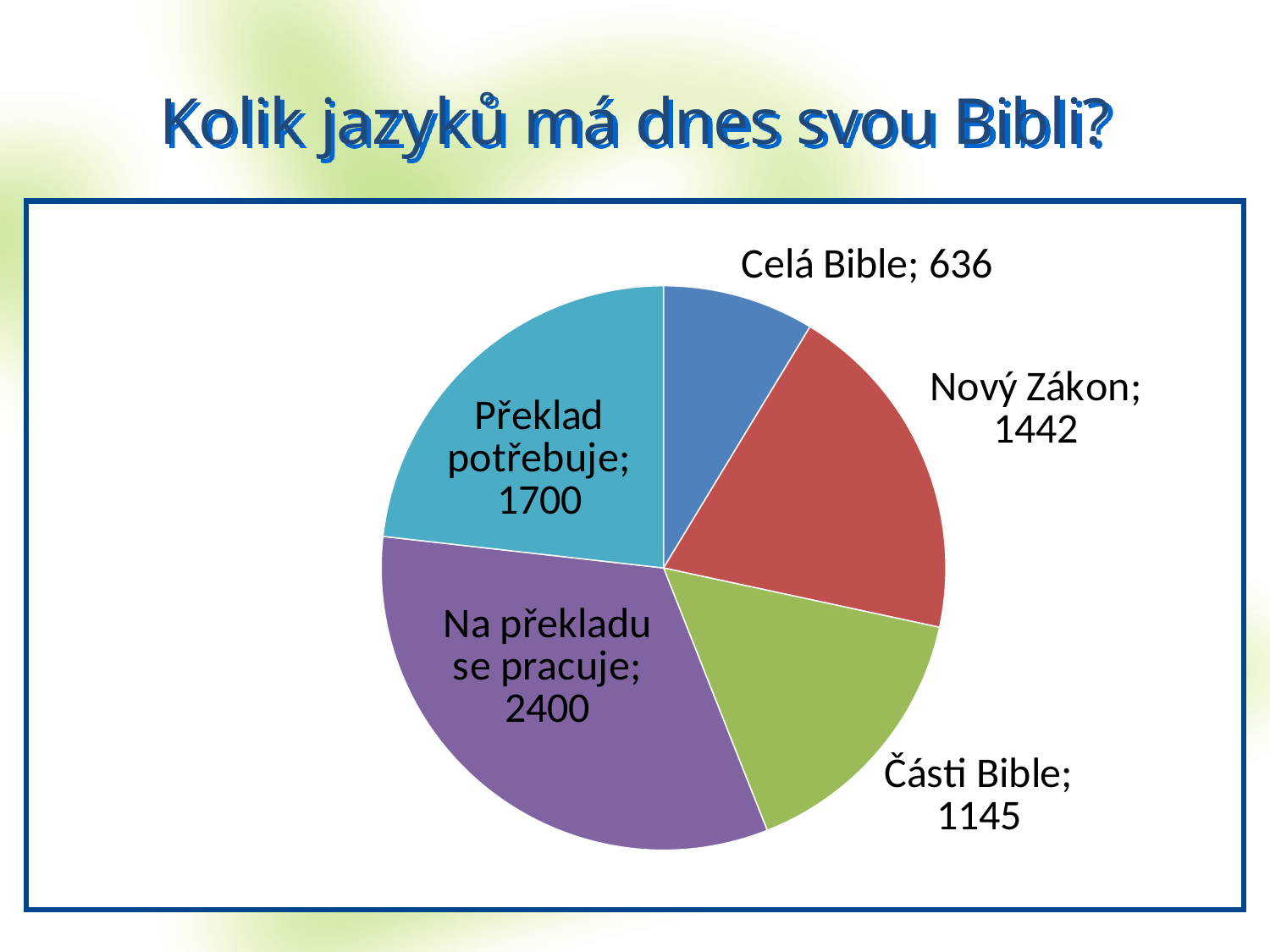
What kind of chart is shown on the slide? Pie chart Which category has the smallest slice of the pie? Celá Bible What is the difference between the values for Nový Zákon and Části Bible? 297 How many slices does the pie chart have? 5 What value is shown for the Části Bible slice? 1145 Which category has the largest slice of the pie? Na překladu se pracuje Which is larger, the value for Nový Zákon or the value for Překlad potřebuje? Překlad potřebuje What is the title of the slide containing the chart? Kolik jazyků má dnes svou Bibli? What value is shown for the Na překladu se pracuje slice? 2400 What value is shown for the Nový Zákon slice? 1442 What is the difference between the values for Na překladu se pracuje and Překlad potřebuje? 700 What value is shown for the Celá Bible slice? 636